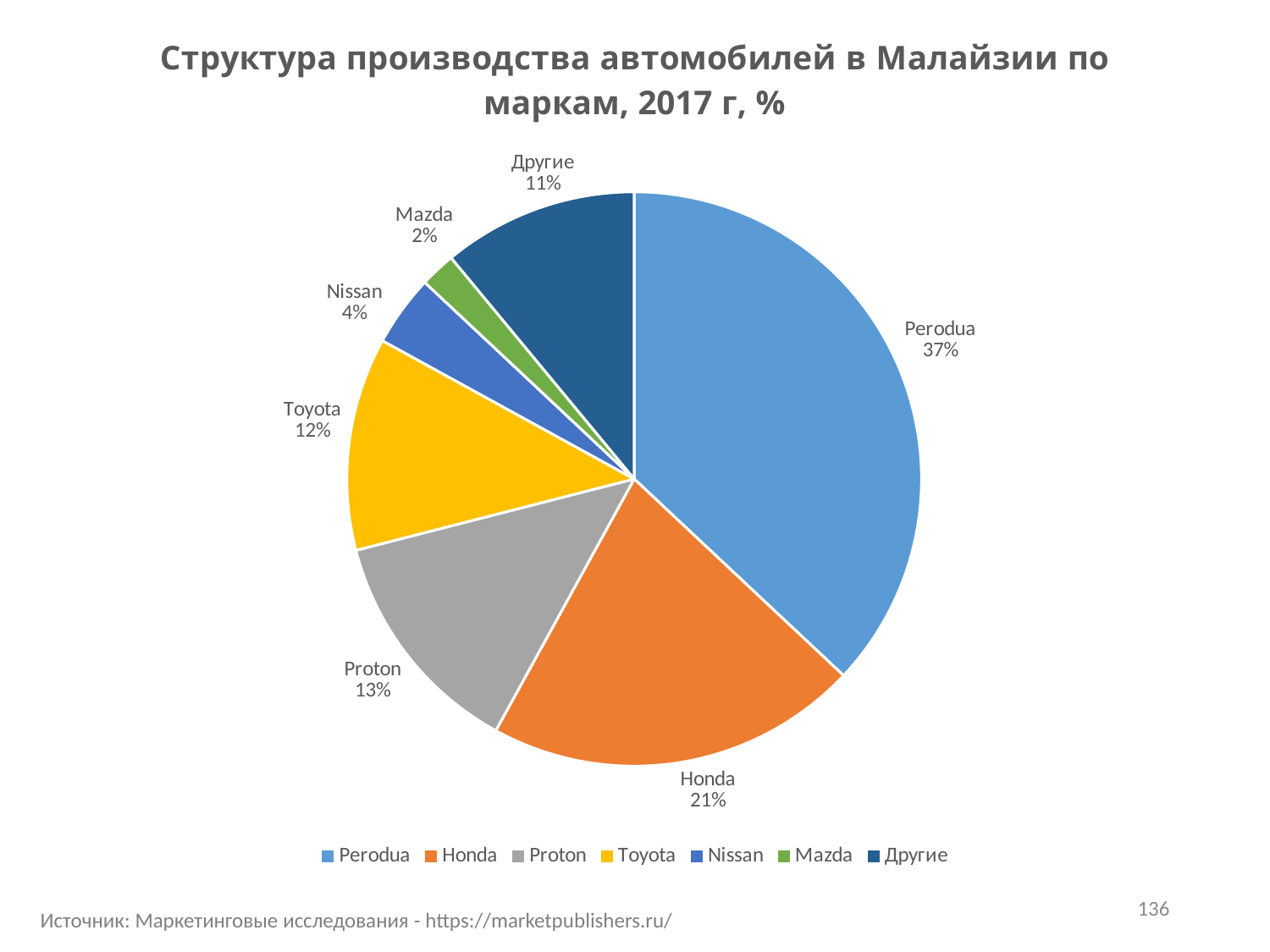
Which brand has the largest slice of the pie? Perodua What is the value shown for Honda? 21% What is the difference in percentage points between Perodua and Honda? 16 What is the value shown for Toyota? 12% What share of the pie does Perodua hold? 37% What share is labelled for the 'Другие' (Others) slice? 11% What kind of chart is shown on the slide? Pie chart How many slices does the pie chart have? 7 What is the title of the chart? Структура производства автомобилей в Малайзии по маркам, 2017 г, % Which brand has the smallest slice of the pie? Mazda What is the value shown for Proton? 13% Which is larger, the share for Nissan or the share for Mazda? Nissan